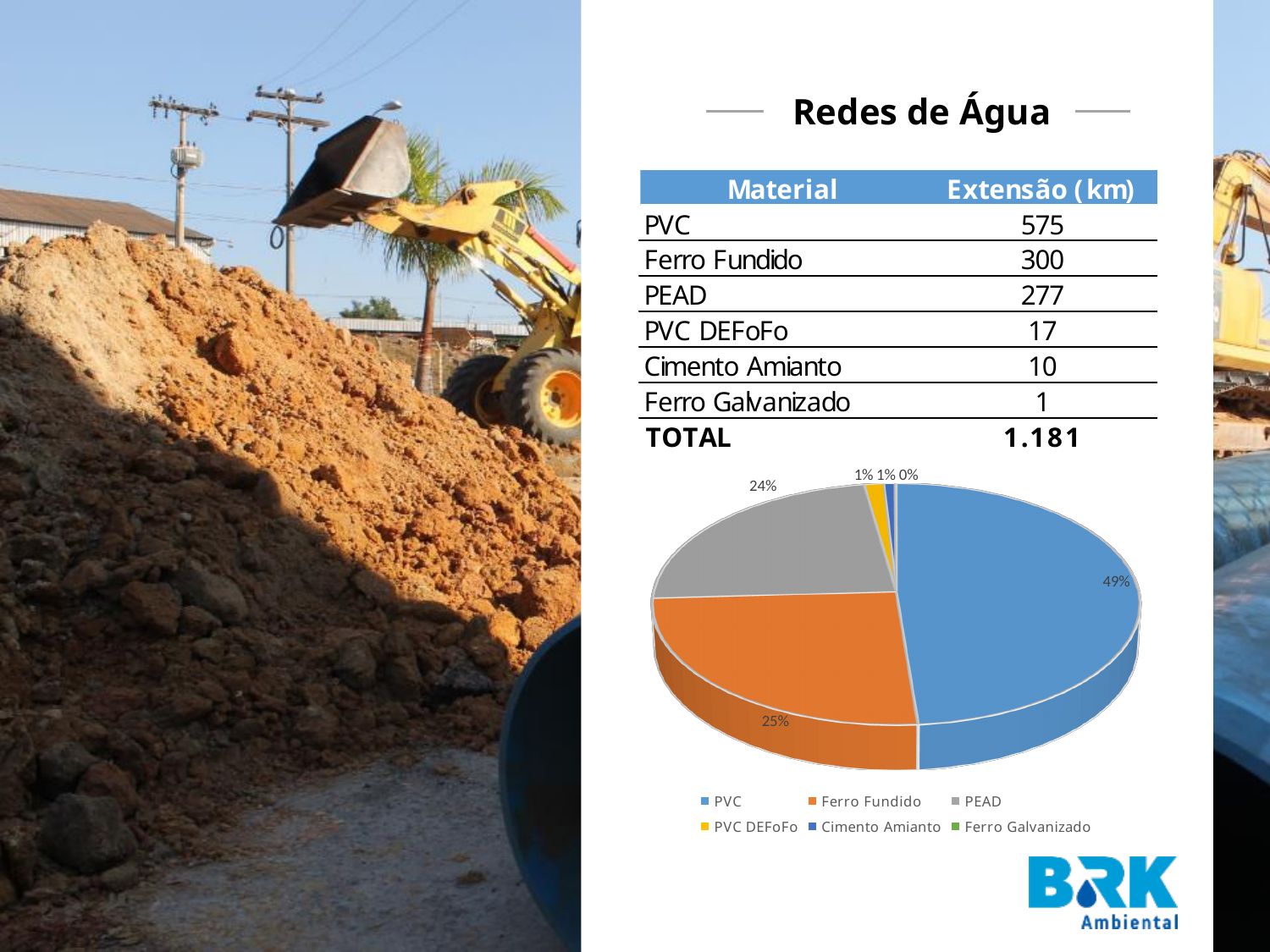
What percentage is shown for the Ferro Fundido slice? 25% What colour is the PVC slice in the pie chart? blue Which material has the largest slice of the pie? PVC What share of the pie does PVC represent? 49% What kind of chart is shown on the slide? pie chart Which material has the smallest slice of the pie? Ferro Galvanizado How many slices does the pie chart have? 6 What percentage is shown for the Ferro Galvanizado slice? 0% What percentage is shown for the PEAD slice? 24% Which slice is larger, PVC or PEAD? PVC What is the difference in percentage points between the PVC slice and the Ferro Fundido slice? 24% How many entries does the legend of the pie chart list? 6